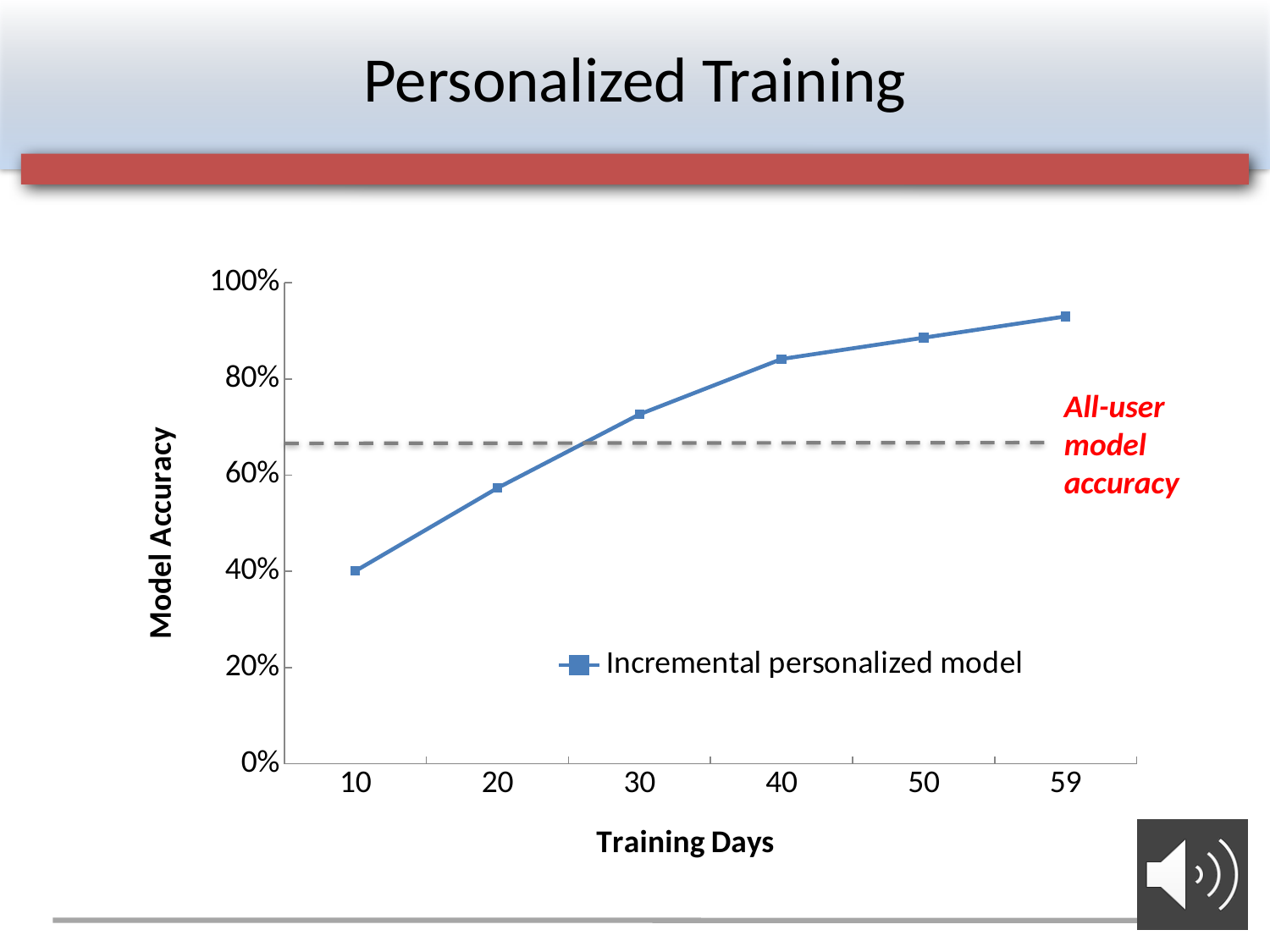
At which number of training days is model accuracy highest? 59 How many data points are plotted for the Incremental personalized model series? 6 How many series does the legend list? 1 What kind of chart is shown on the slide? line chart Which has higher model accuracy: 20 training days or 40 training days? 40 training days What is the title of the x axis? Training Days Is the model accuracy at 30 training days greater or less than 60%? greater What does the dashed horizontal line represent? All-user model accuracy Is the model accuracy at 20 training days greater or less than 60%? less Is the model accuracy at 50 training days greater or less than 80%? greater Does model accuracy rise or fall as training days increase? rise At which number of training days is model accuracy lowest? 10